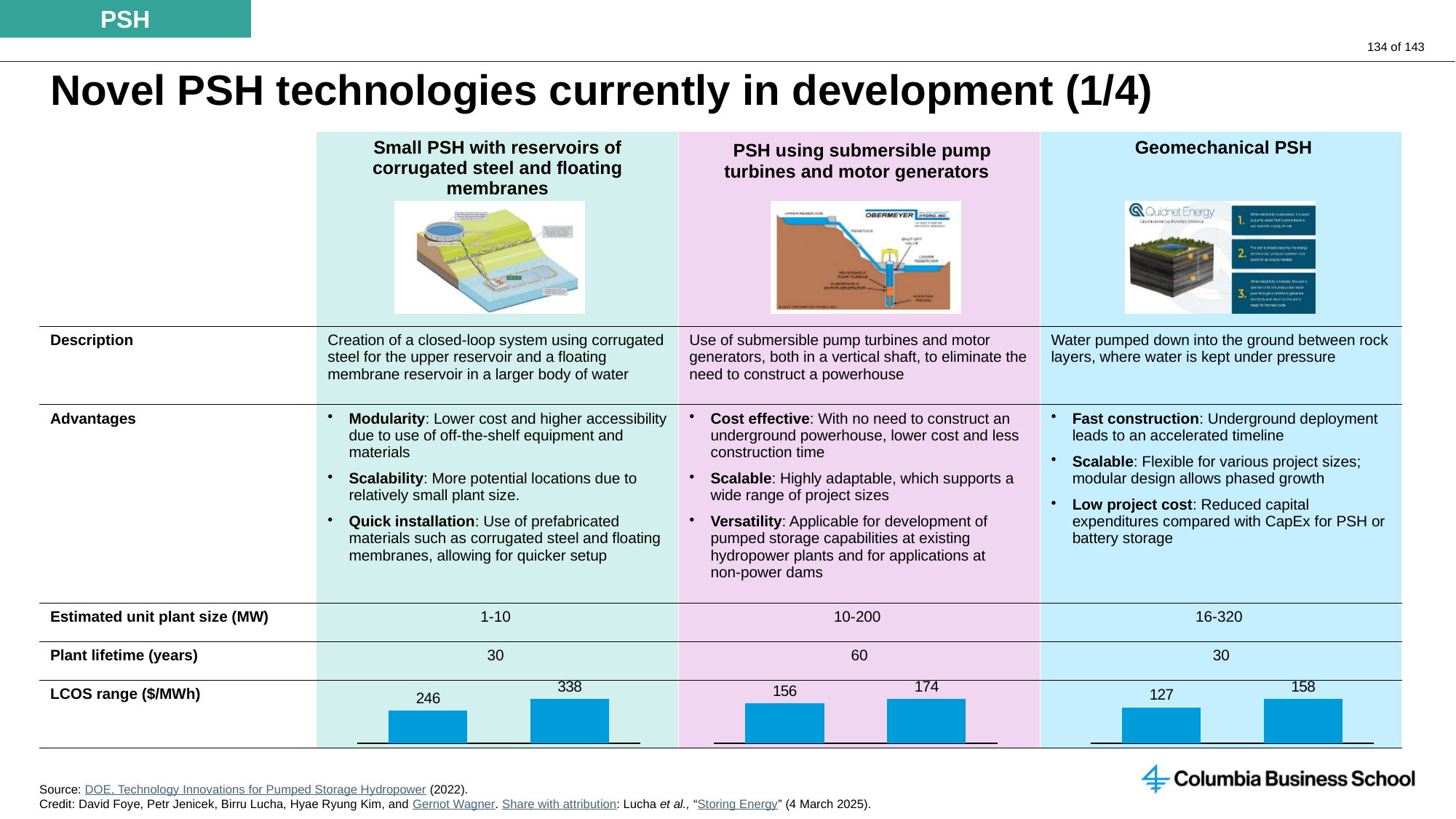
In the LCOS range chart for Small PSH with reservoirs of corrugated steel and floating membranes, what is the difference between the two labelled values? 92 In the LCOS range chart for PSH using submersible pump turbines and motor generators, what is the difference between the two labelled values? 18 In the LCOS range chart for Geomechanical PSH, what is the difference between the two labelled values? 31 In the LCOS range chart for PSH using submersible pump turbines and motor generators, what value is labelled on the left bar? 156 In the LCOS range chart for Geomechanical PSH, which bar is taller, the left or the right? right In the LCOS range chart for Geomechanical PSH, what value is labelled on the left bar? 127 In the LCOS range chart for Small PSH with reservoirs of corrugated steel and floating membranes, what value is labelled on the left bar? 246 How many bars are shown in the LCOS range chart for Small PSH with reservoirs of corrugated steel and floating membranes? 2 In the LCOS range chart for Geomechanical PSH, what value is labelled on the right bar? 158 In the LCOS range chart for PSH using submersible pump turbines and motor generators, what value is labelled on the right bar? 174 In the LCOS range chart for Small PSH with reservoirs of corrugated steel and floating membranes, what value is labelled on the right bar? 338 What kind of chart is used to show the LCOS range for Geomechanical PSH? bar chart